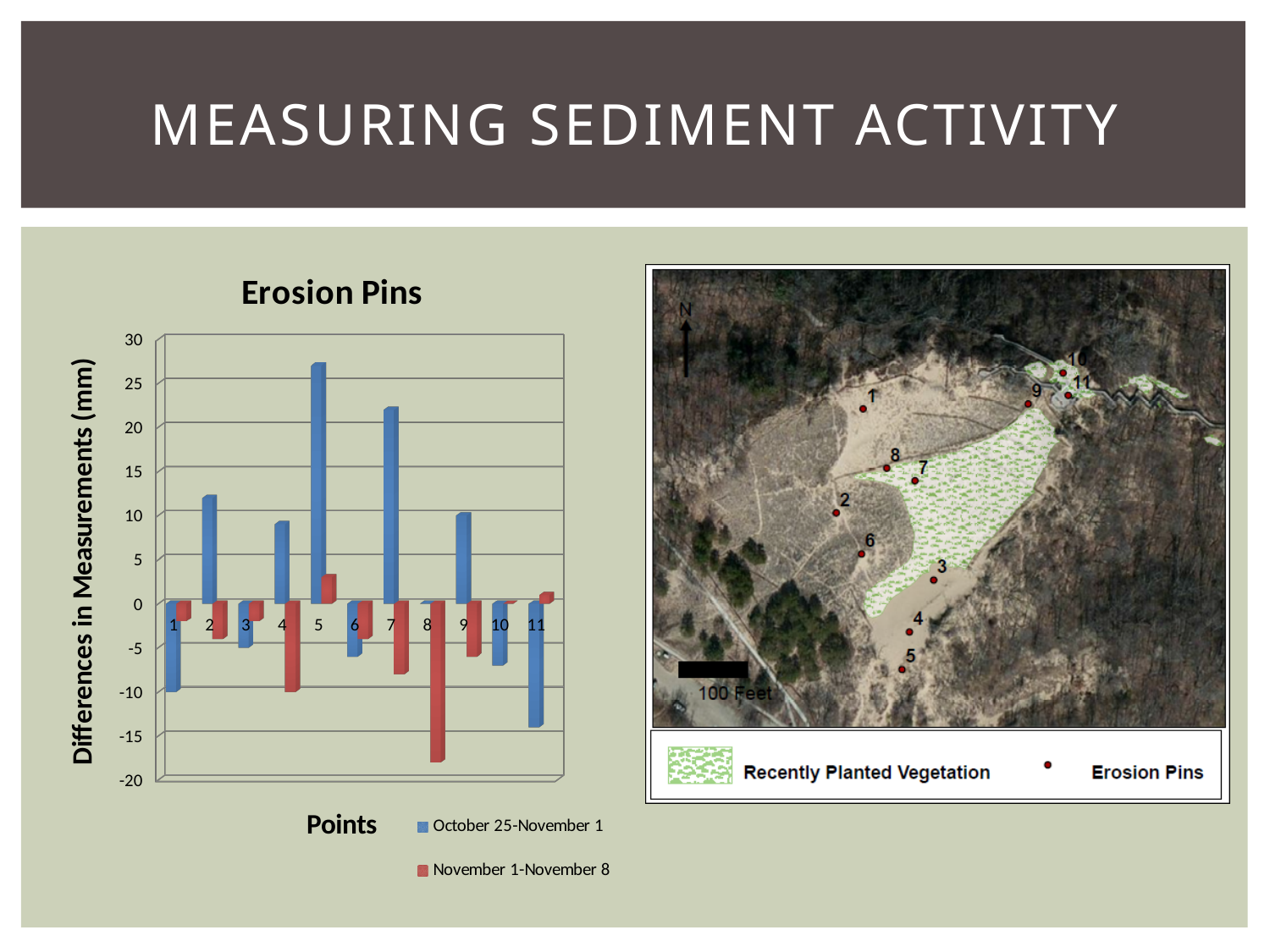
How many series does the legend of the Erosion Pins chart list? 2 Which point has the highest value for the October 25-November 1 series in the Erosion Pins chart? 5 Which point has the lowest value for the October 25-November 1 series in the Erosion Pins chart? 11 Which point has the highest value for the November 1-November 8 series in the Erosion Pins chart? 5 How many points are shown on the x axis of the Erosion Pins chart? 11 In the Erosion Pins chart, which is larger for the October 25-November 1 series: point 5 or point 7? point 5 In the Erosion Pins chart, is the October 25-November 1 value for point 11 greater or less than -10? less In the Erosion Pins chart, is the October 25-November 1 value for point 5 greater or less than 25? greater In the Erosion Pins chart, is the November 1-November 8 value for point 8 greater or less than -15? less What is the y-axis label of the Erosion Pins chart? Differences in Measurements (mm) What kind of chart is the Erosion Pins chart? bar chart Which point has the lowest value for the November 1-November 8 series in the Erosion Pins chart? 8